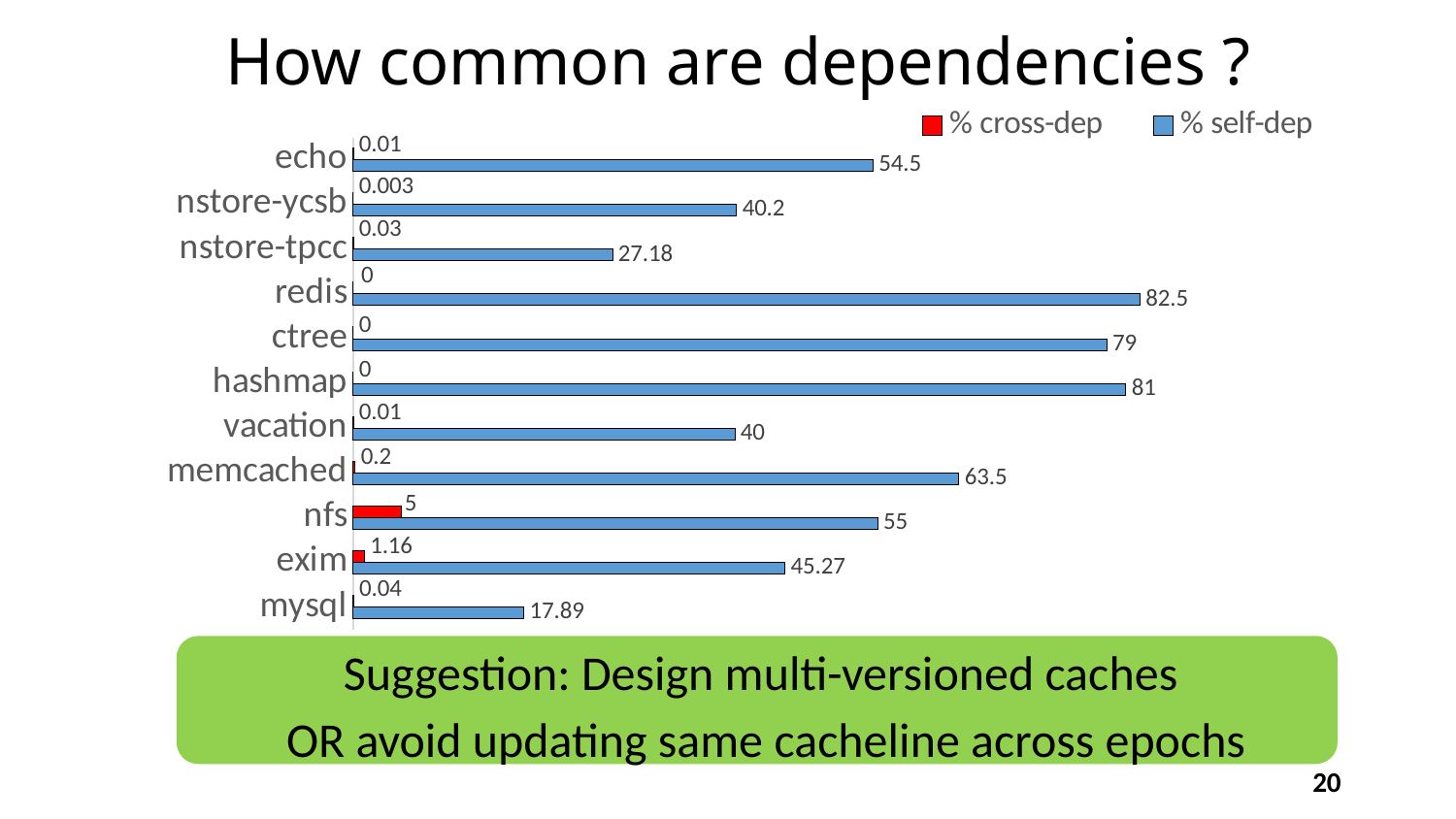
How many series does the legend list? 2 What is the difference between the % self-dep values for hashmap and ctree? 2 What is the % cross-dep value for exim? 1.16 Which category has the highest % self-dep value? redis What is the % self-dep value for redis? 82.5 What is the % self-dep value for mysql? 17.89 Which category has the lowest % self-dep value? mysql What is the % cross-dep value for nfs? 5 Which has a larger % self-dep value, memcached or echo? memcached Which category has the highest % cross-dep value? nfs How many categories are shown in the chart? 11 What kind of chart is shown on the slide? bar chart